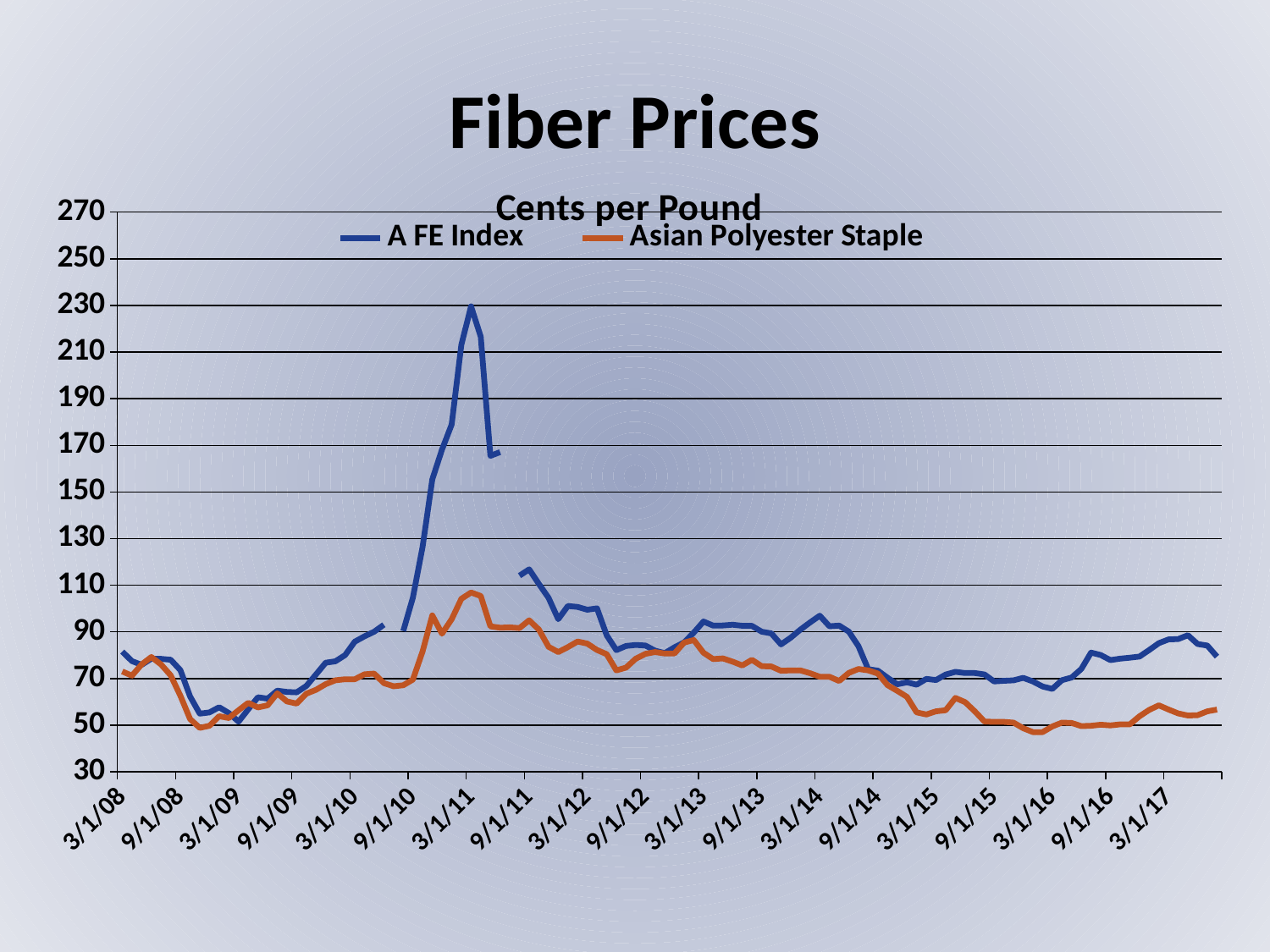
What is the title of the chart? Cents per Pound Does Asian Polyester Staple rise or fall between 3/1/13 and 3/1/16? fall At 3/1/11, which series has the larger value, A FE Index or Asian Polyester Staple? A FE Index Is the value of Asian Polyester Staple at 3/1/16 greater or less than 70? less Does the A FE Index rise or fall between 3/1/11 and 9/1/11? fall Which series reaches the highest value on the chart? A FE Index Is the value of the A FE Index at 3/1/08 greater or less than 70? greater What unit is given in the chart's subtitle? Cents per Pound Is the peak value of the A FE Index around 3/1/11 greater or less than 210? greater What kind of chart is shown on the slide? line chart How many series does the legend list? 2